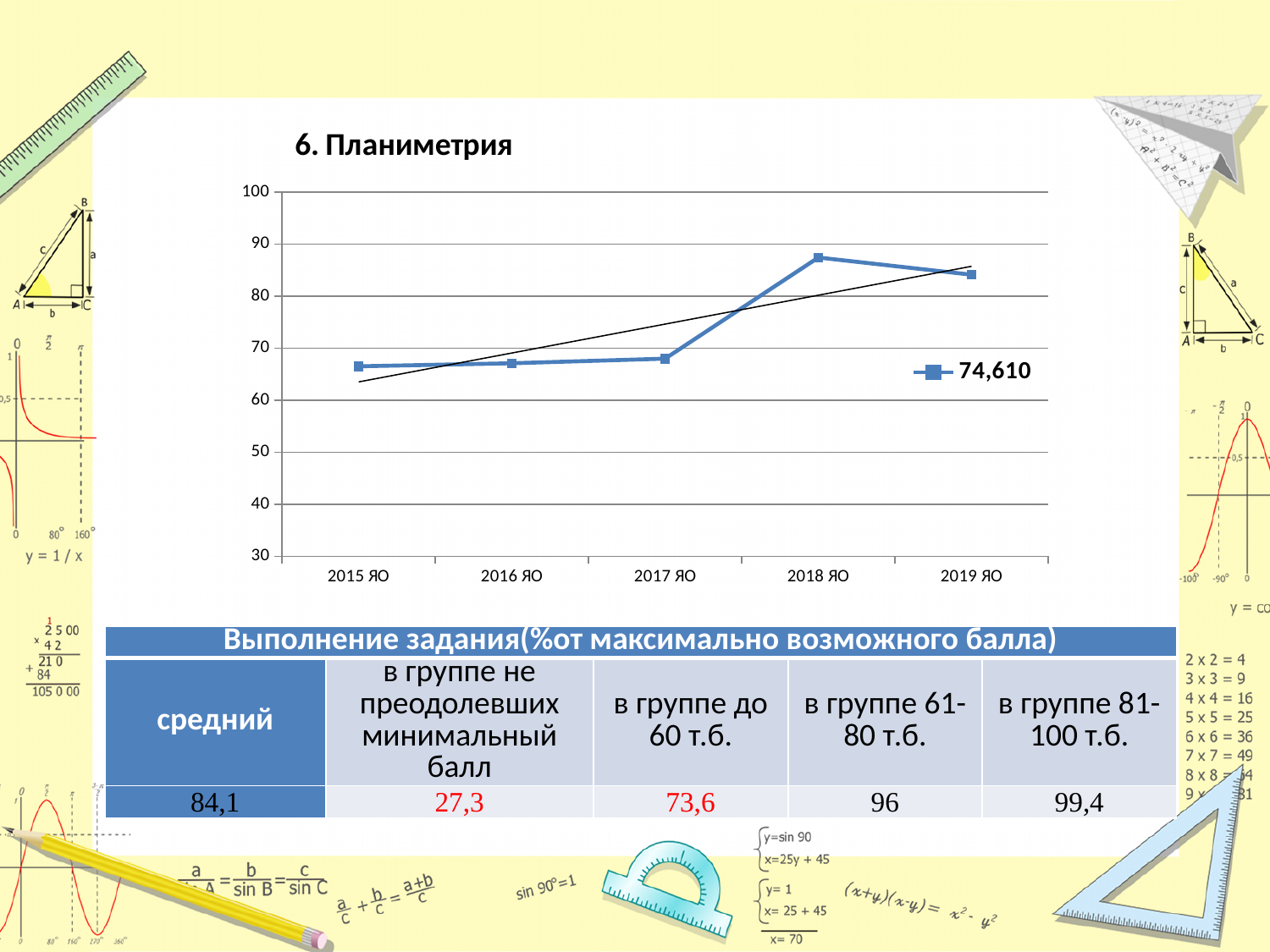
Is the value for 2018 ЯО greater or less than 80? greater Is the value for 2015 ЯО greater or less than 70? less Do the values generally rise or fall from 2015 ЯО to 2019 ЯО? rise How many data points are plotted on the line chart? 5 Which year has the highest value on the chart? 2018 ЯО What is the legend entry shown on the chart? 74,610 Which is larger, the value for 2018 ЯО or the value for 2017 ЯО? 2018 ЯО How many series does the chart legend list? 1 Is the value for 2017 ЯО greater or less than 70? less What kind of chart is shown on the slide? line chart What is the title above the chart? 6. Планиметрия